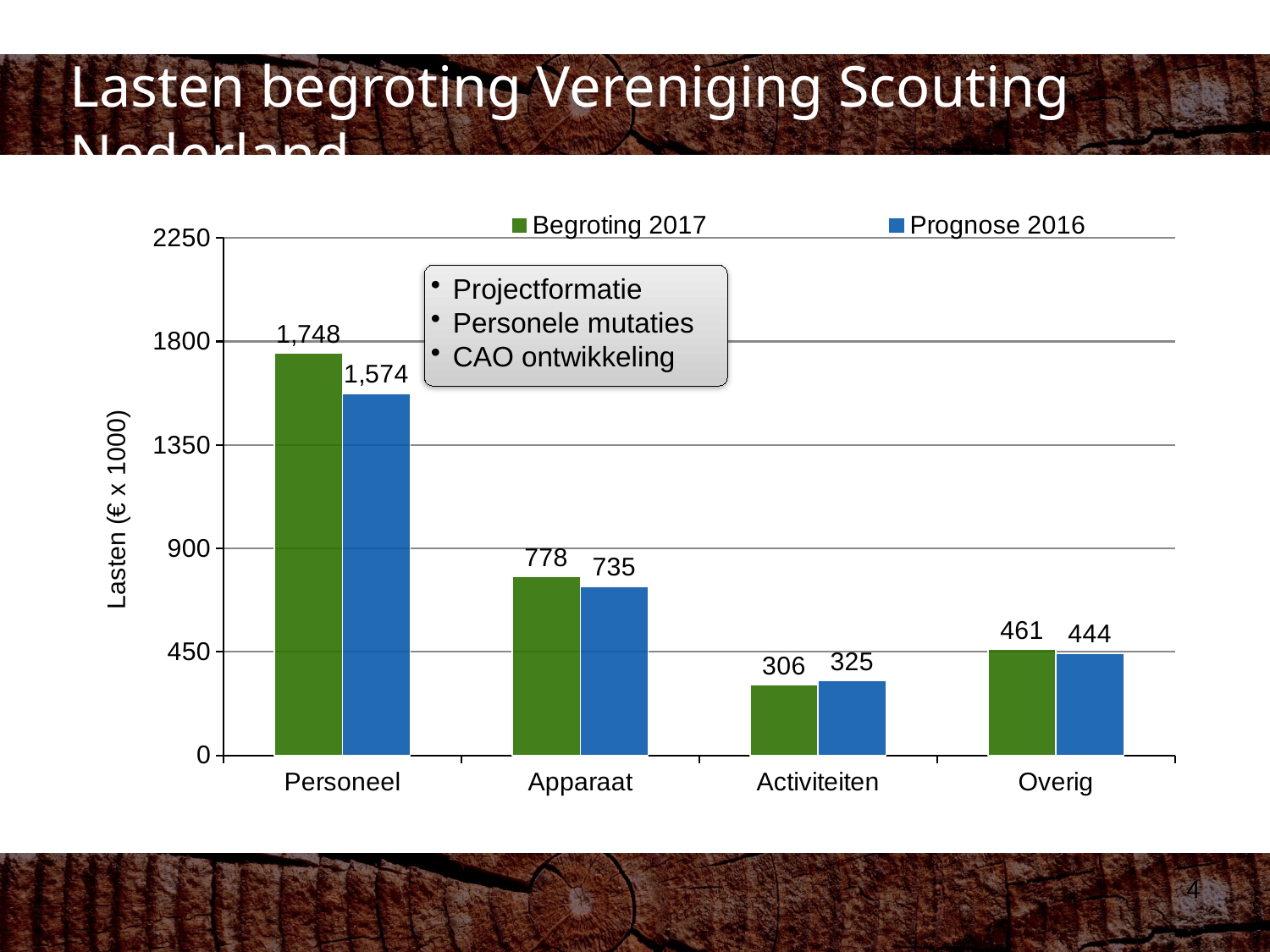
What is the Prognose 2016 value for Overig? 444 How many series does the legend list? 2 What is the difference between the Begroting 2017 and Prognose 2016 values for Personeel? 174 What kind of chart is shown on the slide? Bar chart What is the label of the y axis? Lasten (€ x 1000) What is the Begroting 2017 value for Personeel? 1,748 For Activiteiten, which is larger: Begroting 2017 or Prognose 2016? Prognose 2016 What is the Begroting 2017 value for Activiteiten? 306 Which category has the lowest Prognose 2016 value? Activiteiten Which category has the highest Begroting 2017 value? Personeel How many categories are shown on the x axis? 4 What is the Prognose 2016 value for Apparaat? 735